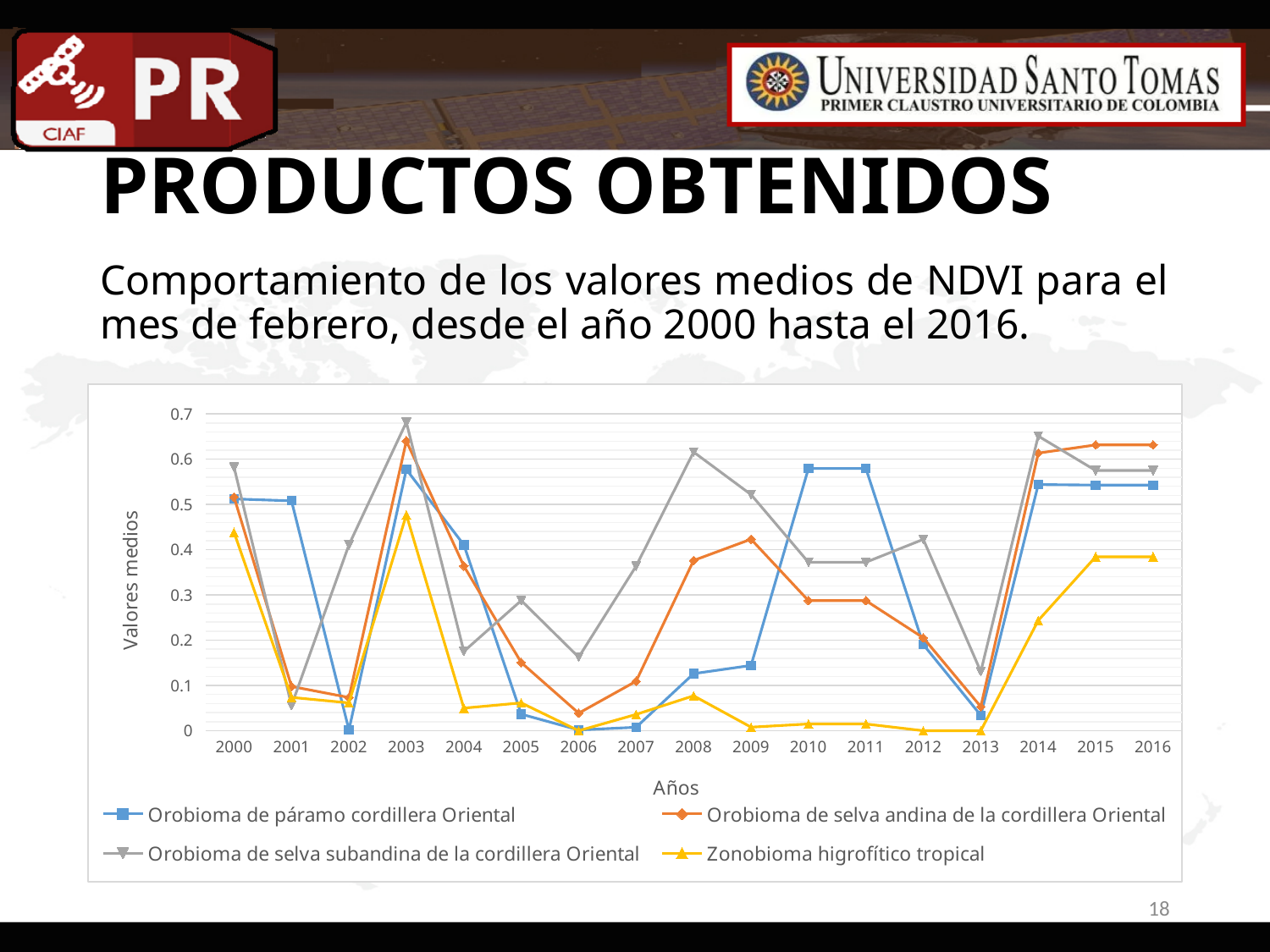
Is the value for Zonobioma higrofítico tropical in 2016 greater or less than 0.3? greater Which series has the highest value in 2008? Orobioma de selva subandina de la cordillera Oriental How many years are plotted along the x axis of the chart? 17 What kind of chart is shown on the slide? line chart Does the value for Orobioma de selva andina de la cordillera Oriental rise or fall from 2013 to 2015? rise Which series has the lowest value in 2012? Zonobioma higrofítico tropical Is the value for Orobioma de selva andina de la cordillera Oriental in 2015 greater or less than 0.6? greater Is the value for Orobioma de selva subandina de la cordillera Oriental in 2003 greater or less than 0.6? greater In 2010, which series has the larger value: Orobioma de páramo cordillera Oriental or Orobioma de selva andina de la cordillera Oriental? Orobioma de páramo cordillera Oriental How many series does the chart legend list? 4 What is the title of the x axis of the chart? Años